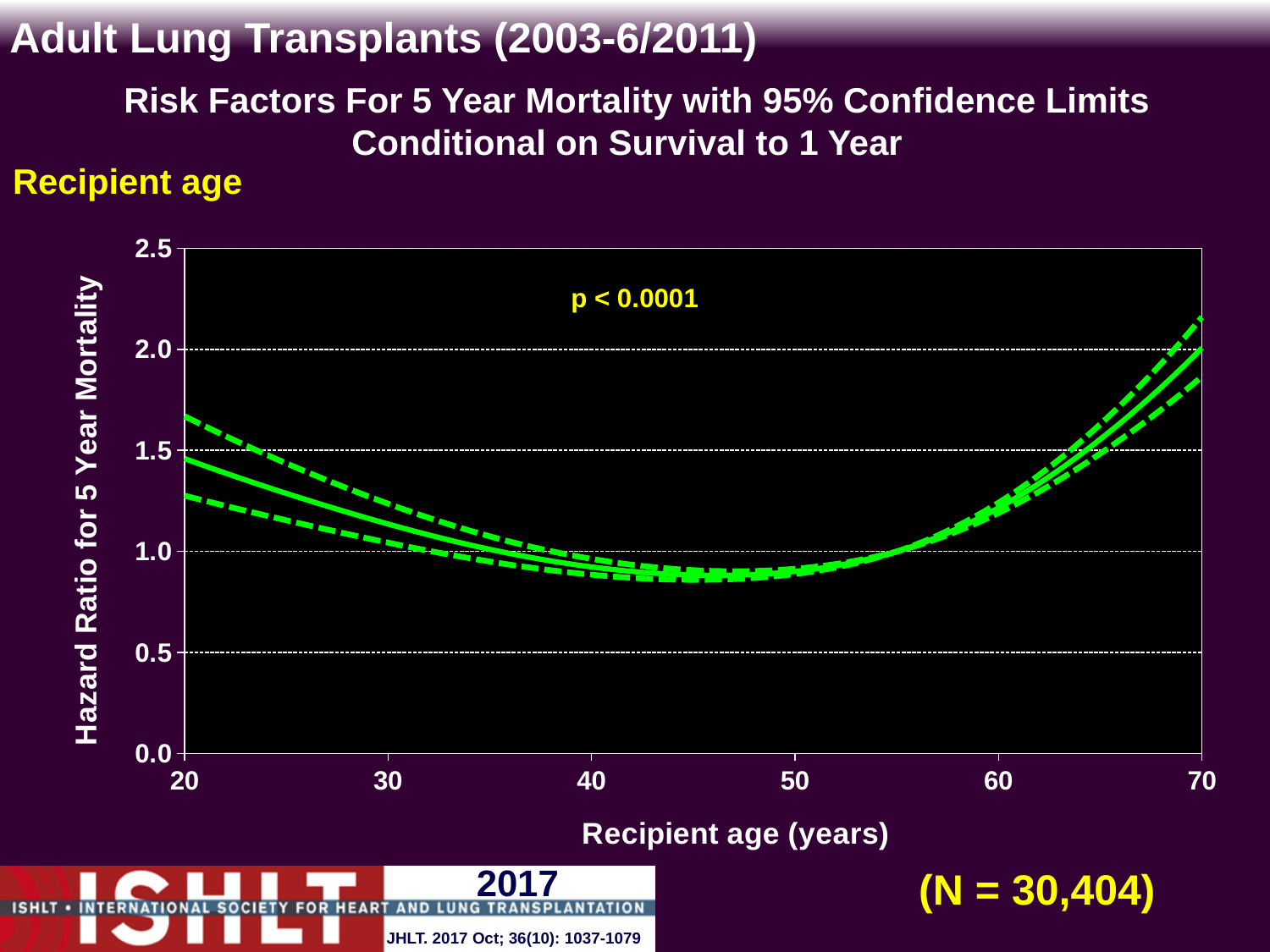
Is the hazard ratio on the solid line at recipient age 65 greater or less than 2.0? less What p-value is printed on the chart? p < 0.0001 Is the hazard ratio on the solid line at recipient age 60 greater or less than 1.0? greater Is the hazard ratio on the solid line at recipient age 20 greater or less than 1.0? greater What is the label of the y axis? Hazard Ratio for 5 Year Mortality What kind of chart is shown on the slide? line chart How many lines are plotted on the chart? 3 Does the solid hazard ratio line rise or fall as recipient age increases from 20 to 45 years? fall What is the sample size (N) shown on the slide? N = 30,404 What is the label of the x axis? Recipient age (years) Does the solid hazard ratio line rise or fall as recipient age increases from 50 to 70 years? rise